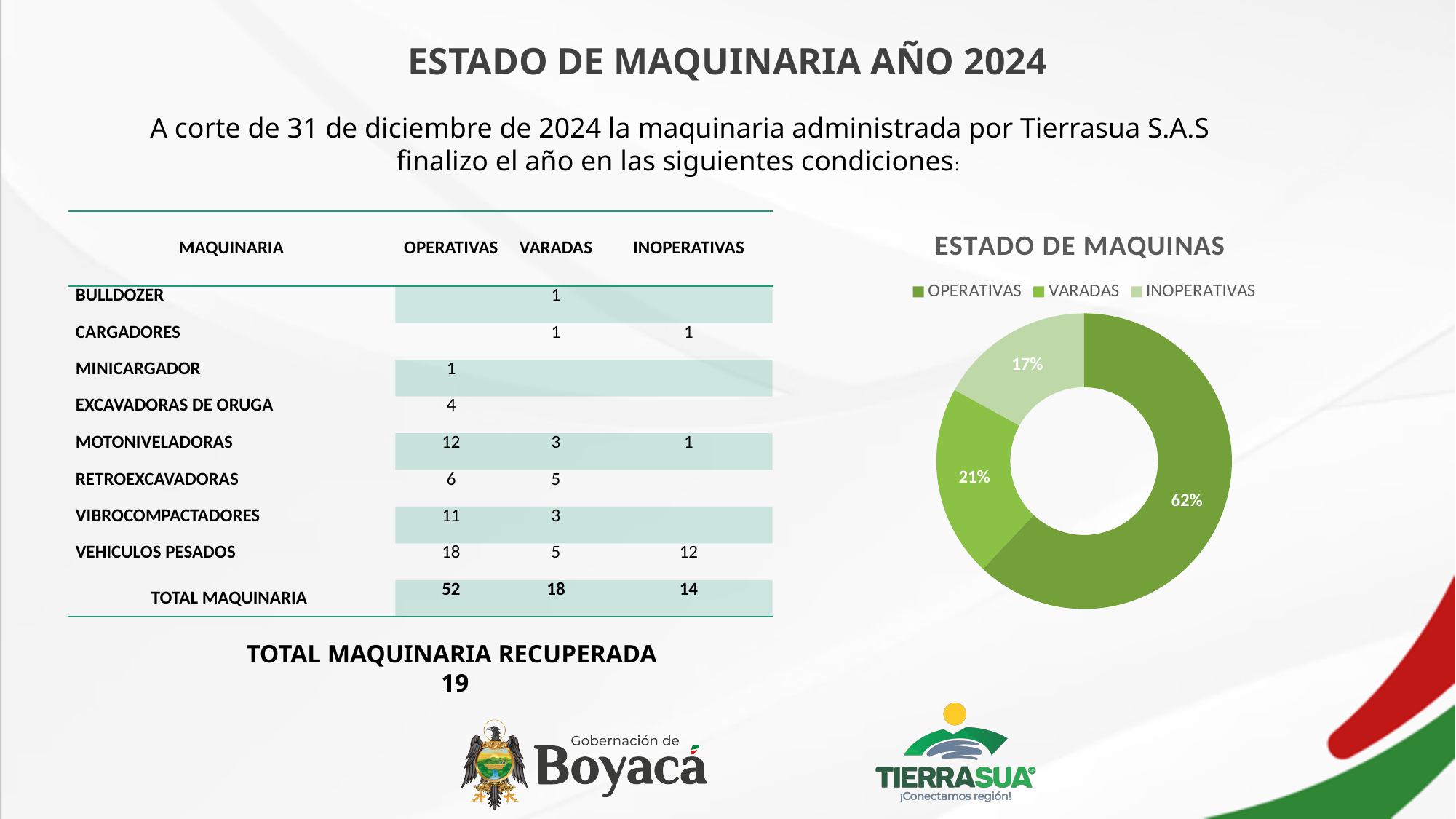
How many slices does the "ESTADO DE MAQUINAS" chart have? 3 How many entries does the legend of the "ESTADO DE MAQUINAS" chart list? 3 In the "ESTADO DE MAQUINAS" chart, what share is shown for VARADAS? 21% What kind of chart is "ESTADO DE MAQUINAS"? Doughnut chart In the "ESTADO DE MAQUINAS" chart, what is the difference in percentage points between VARADAS and INOPERATIVAS? 4 In the "ESTADO DE MAQUINAS" chart, which slice is larger, VARADAS or INOPERATIVAS? VARADAS In the "ESTADO DE MAQUINAS" chart, what is the difference in percentage points between OPERATIVAS and VARADAS? 41 Which category has the smallest slice in the "ESTADO DE MAQUINAS" chart? INOPERATIVAS In the "ESTADO DE MAQUINAS" chart, what share is shown for INOPERATIVAS? 17% Which category has the largest slice in the "ESTADO DE MAQUINAS" chart? OPERATIVAS In the "ESTADO DE MAQUINAS" chart, what share is shown for OPERATIVAS? 62% What is the title of the doughnut chart on the slide? ESTADO DE MAQUINAS